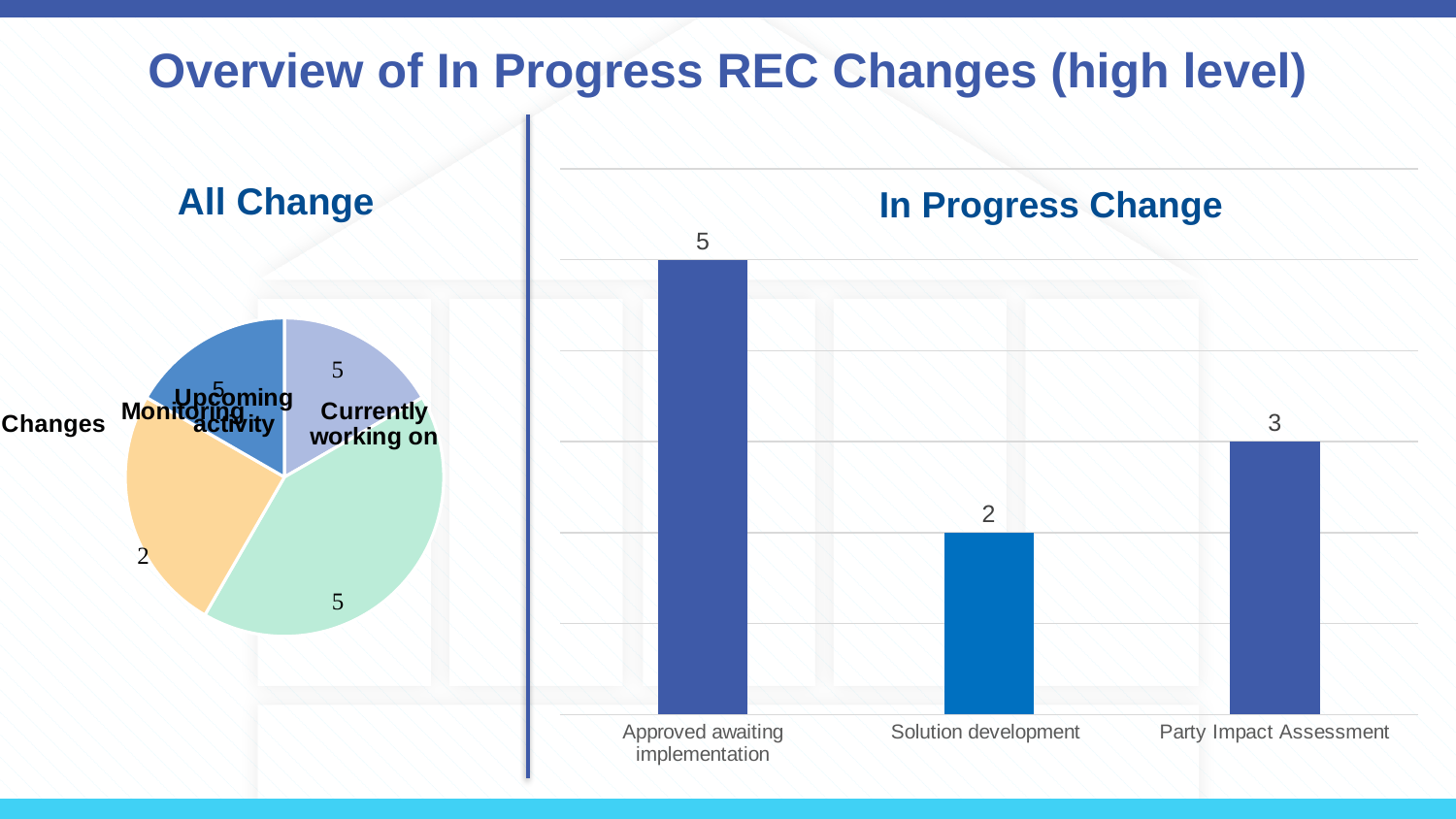
In the 'In Progress Change' chart, which category has the highest value? Approved awaiting implementation What type of chart is the 'All Change' chart? Pie chart In the 'In Progress Change' chart, what is the value for Party Impact Assessment? 3 What type of chart is the 'In Progress Change' chart? Bar chart In the 'In Progress Change' chart, what is the value for Approved awaiting implementation? 5 In the 'In Progress Change' chart, which category has the lowest value? Solution development In the 'In Progress Change' chart, what is the value for Solution development? 2 In the 'In Progress Change' chart, which is larger: Solution development or Party Impact Assessment? Party Impact Assessment How many categories are shown in the 'In Progress Change' chart? 3 How many slices does the 'All Change' pie chart have? 4 In the 'All Change' pie chart, what is the value for Currently working on? 5 In the 'In Progress Change' chart, what is the difference between Approved awaiting implementation and Party Impact Assessment? 2